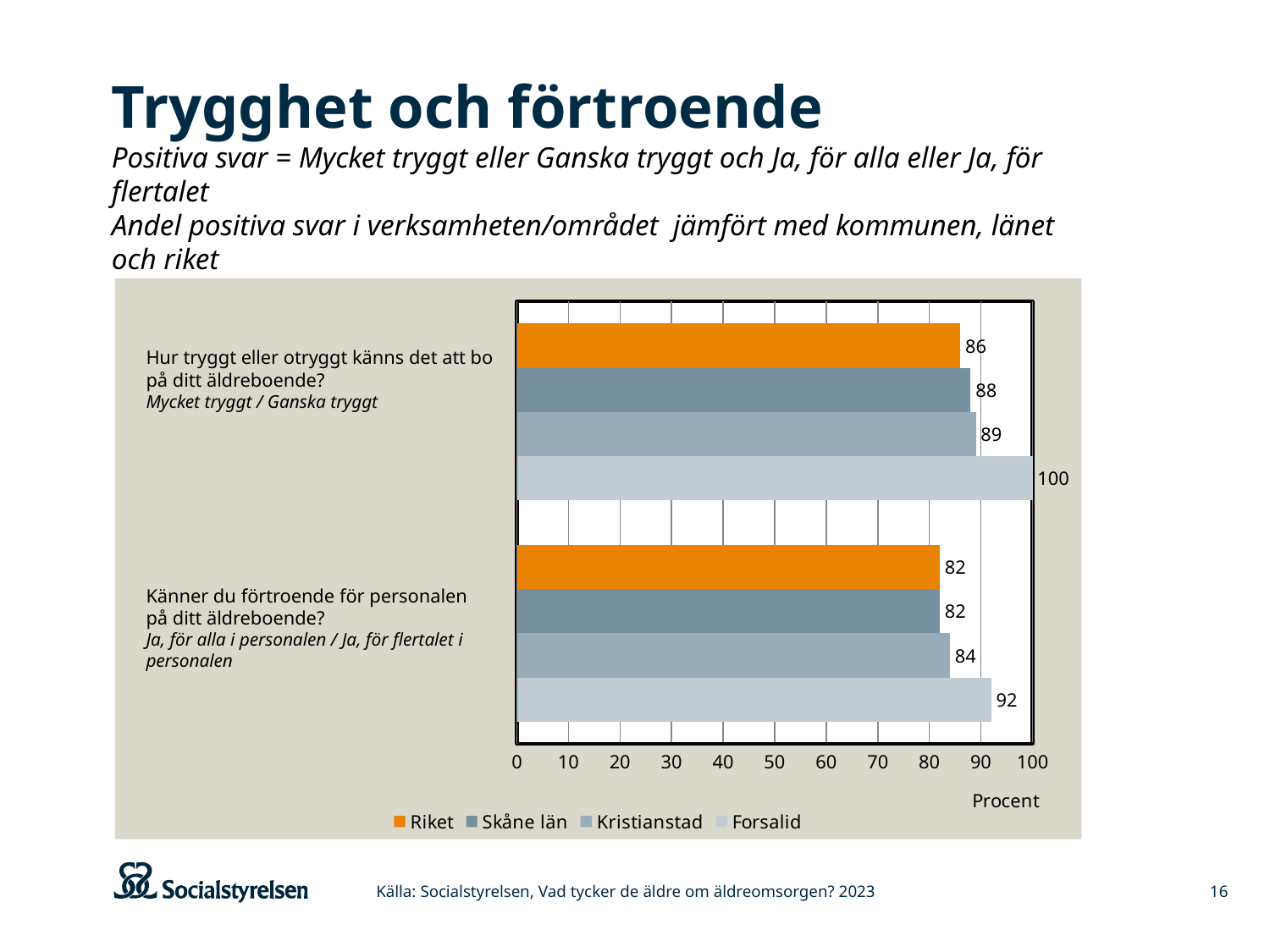
How many series does the legend list? 4 Which is larger: the Forsalid value for the trygghet question or the Forsalid value for the förtroende question? The trygghet question (100) What is the difference between the Forsalid and Riket values for the question "Hur tryggt eller otryggt känns det att bo på ditt äldreboende?"? 14 Which series has the highest value for the question "Känner du förtroende för personalen på ditt äldreboende?"? Forsalid What value is shown for Kristianstad on the question "Hur tryggt eller otryggt känns det att bo på ditt äldreboende?"? 89 What is the label of the x axis? Procent What value is shown for Riket on the question "Känner du förtroende för personalen på ditt äldreboende?"? 82 What value is shown for Skåne län on the question "Känner du förtroende för personalen på ditt äldreboende?"? 82 What kind of chart is shown on the slide? Bar chart Which series has the lowest value for the question "Hur tryggt eller otryggt känns det att bo på ditt äldreboende?"? Riket What is the difference between the Forsalid and Kristianstad values for the question "Känner du förtroende för personalen på ditt äldreboende?"? 8 What value is shown for Forsalid on the question "Hur tryggt eller otryggt känns det att bo på ditt äldreboende?"? 100